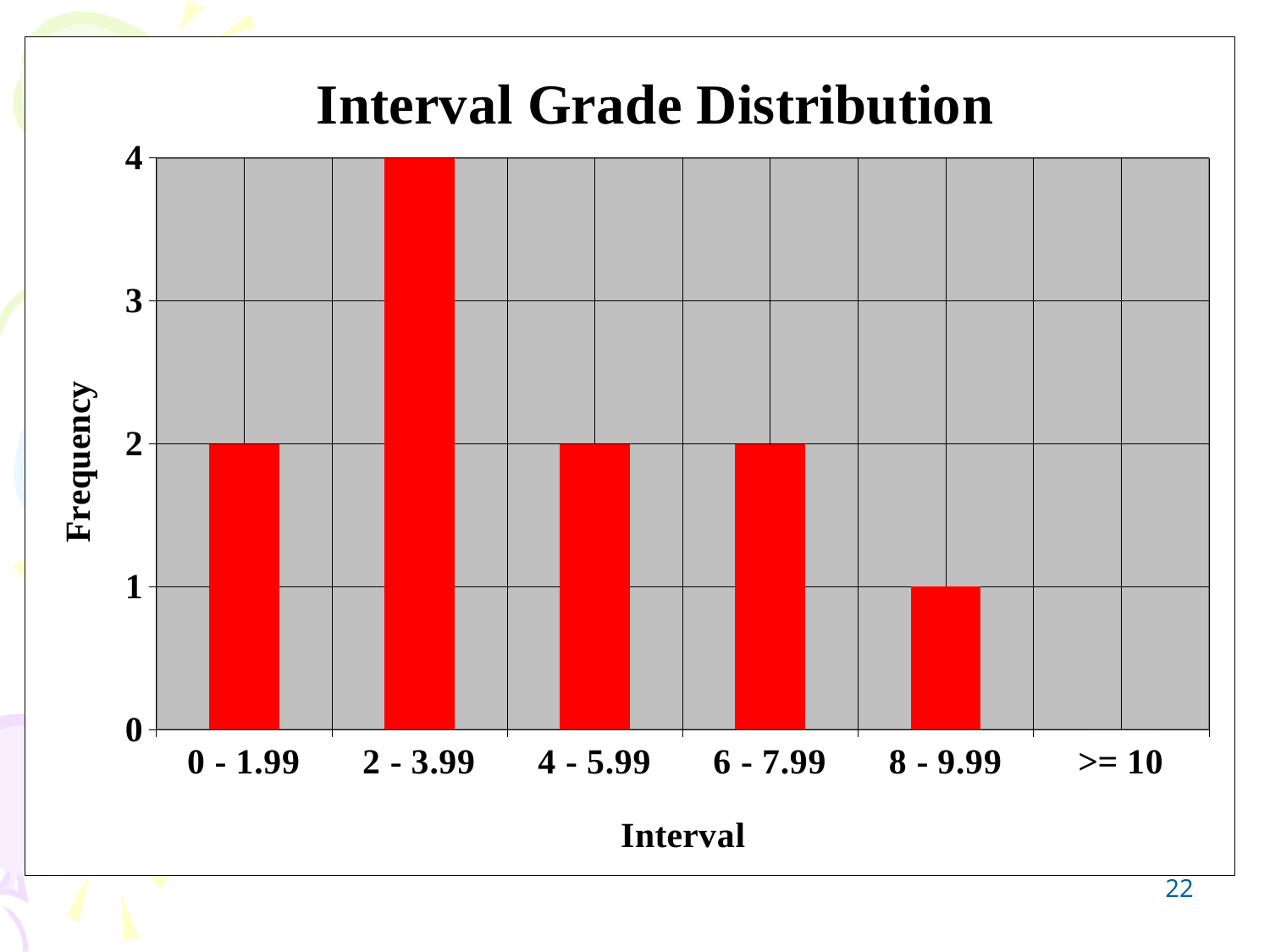
What is the frequency for the interval 2 - 3.99? 4 How many intervals are shown on the x axis? 6 What is the frequency for the interval 6 - 7.99? 2 Which interval has the highest frequency? 2 - 3.99 What is the frequency for the interval 0 - 1.99? 2 Which interval has the lowest frequency? >= 10 What is the label of the y axis? Frequency Which has a larger frequency, the interval 4 - 5.99 or the interval 8 - 9.99? 4 - 5.99 What type of chart is shown on the slide? bar chart What is the difference in frequency between the intervals 2 - 3.99 and 4 - 5.99? 2 What is the title of the chart? Interval Grade Distribution What is the frequency for the interval 8 - 9.99? 1